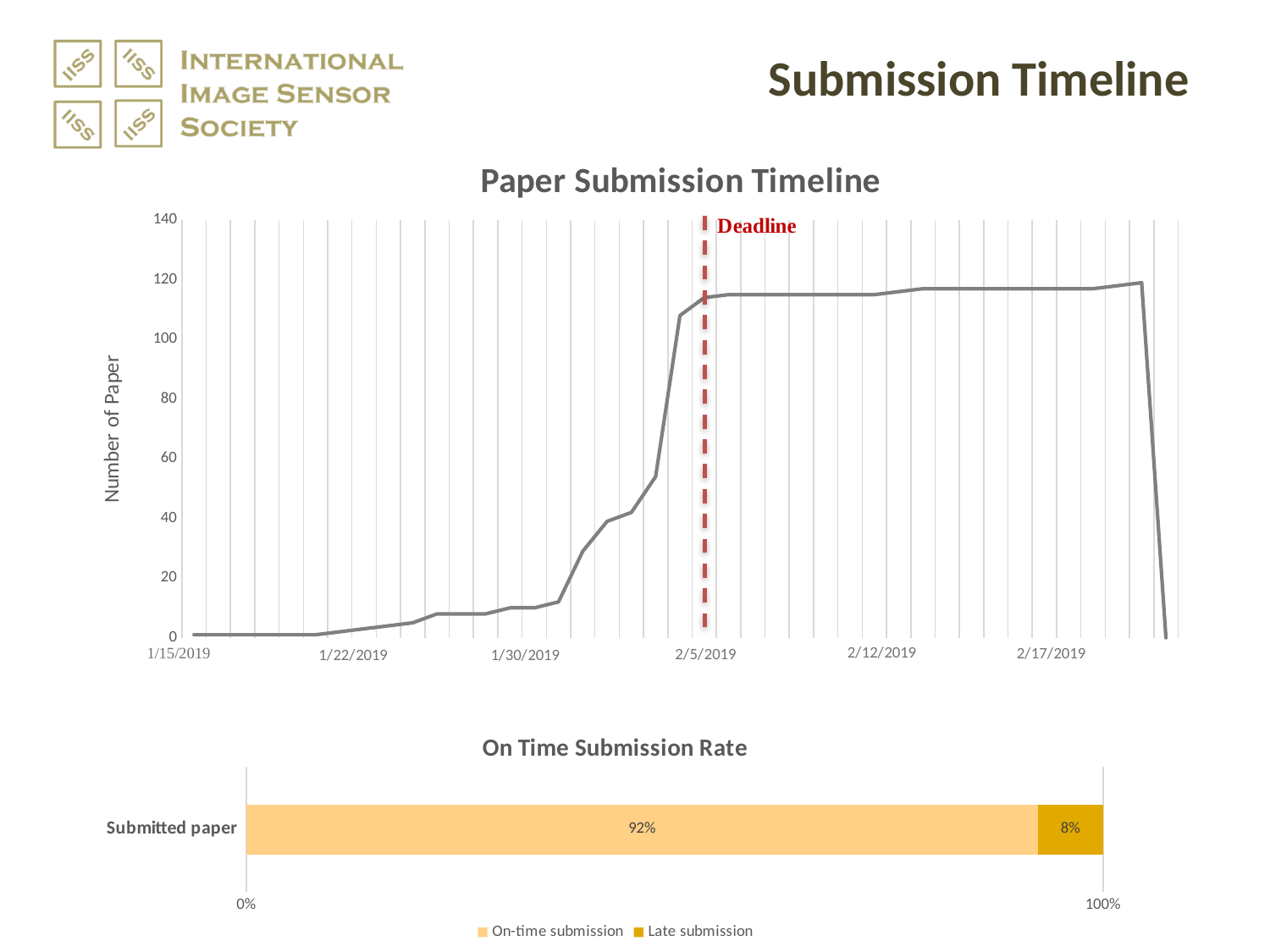
In the "On Time Submission Rate" chart, what is the difference between the On-time submission and Late submission values? 84% What kind of chart is the "On Time Submission Rate" chart? bar chart In the "On Time Submission Rate" chart, what is the value for Late submission? 8% In the "Paper Submission Timeline" chart, is the number of papers on 1/30/2019 greater or less than 20? less In the "On Time Submission Rate" chart, what is the value for On-time submission? 92% In the "Paper Submission Timeline" chart, is the number of papers on 2/5/2019 greater or less than 100? greater What kind of chart is the "Paper Submission Timeline" chart? line chart In the "On Time Submission Rate" chart, which is larger, On-time submission or Late submission? On-time submission What is the y-axis title of the "Paper Submission Timeline" chart? Number of Paper In the "On Time Submission Rate" chart, what is the total of the stacked bar for Submitted paper? 100% How many series does the legend of the "On Time Submission Rate" chart list? 2 In the "Paper Submission Timeline" chart, do the values generally rise or fall from 1/15/2019 to 2/5/2019? rise